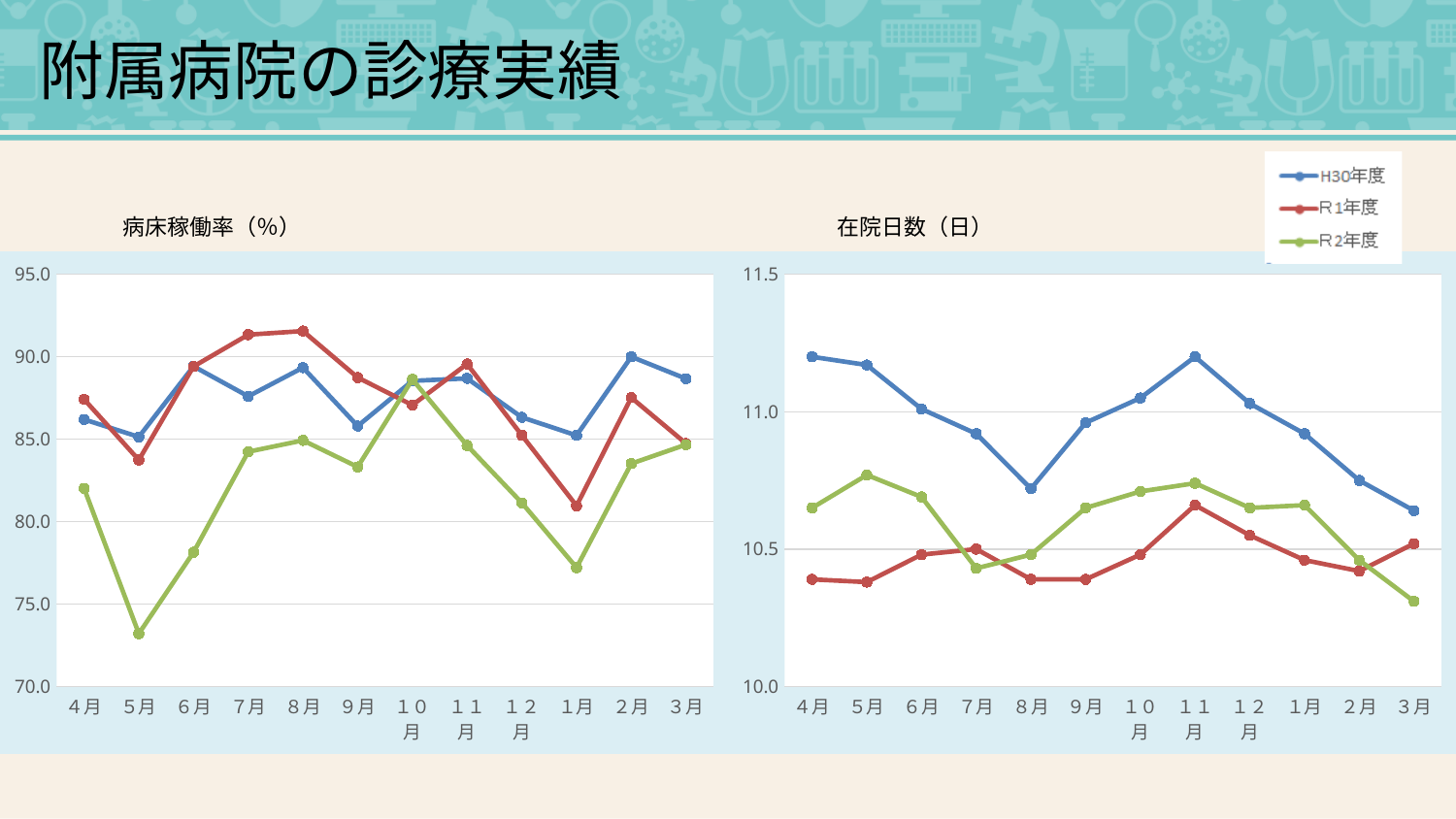
In the 病床稼働率（%） chart, which is larger in 5月, H30年度 or R2年度? H30年度 In the 在院日数（日） chart, is the value for R2年度 in 3月 greater or less than 10.5? less What colour is the R1年度 line in the legend? red In the 病床稼働率（%） chart, how many months are plotted along the x axis? 12 In the 病床稼働率（%） chart, is the value for R2年度 in 5月 greater or less than 75.0? less How many series does the legend list? 3 In the 病床稼働率（%） chart, which month has the lowest value for R2年度? 5月 What kind of chart is the 病床稼働率（%） chart? line chart In the 在院日数（日） chart, which month has the lowest value for R2年度? 3月 In the 在院日数（日） chart, does the H30年度 line rise or fall from 11月 to 3月? fall In the 病床稼働率（%） chart, is the value for R1年度 in 8月 greater or less than 90.0? greater